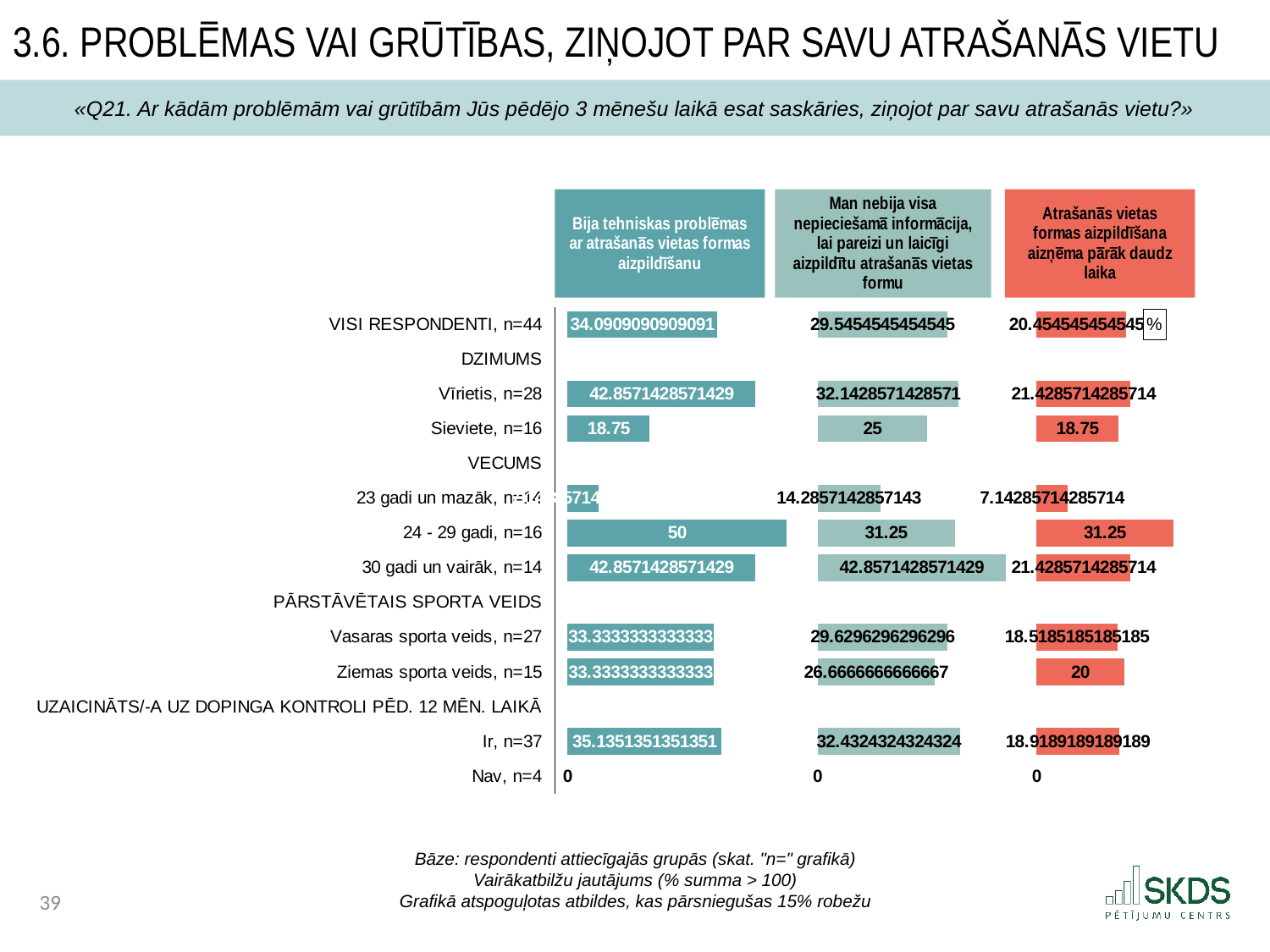
In the middle chart ("Man nebija visa nepieciešamā informācija..."), what is the value for "30 gadi un vairāk, n=14"? 42.8571428571429 In the chart titled "Bija tehniskas problēmas ar atrašanās vietas formas aizpildīšanu", what is the difference between the values for "24 - 29 gadi, n=16" and "Sieviete, n=16"? 31.25 In the chart titled "Bija tehniskas problēmas ar atrašanās vietas formas aizpildīšanu", what is the value for "24 - 29 gadi, n=16"? 50 In the rightmost chart ("Atrašanās vietas formas aizpildīšana aizņēma pārāk daudz laika"), what is the difference between the values for "24 - 29 gadi, n=16" and "Sieviete, n=16"? 12.5 In the middle chart ("Man nebija visa nepieciešamā informācija..."), which group has the highest value? 30 gadi un vairāk, n=14 What kind of chart is used on this slide? Bar chart In the chart titled "Bija tehniskas problēmas ar atrašanās vietas formas aizpildīšanu", which group has the highest value? 24 - 29 gadi, n=16 How many respondent groups have a value plotted in the chart titled "Bija tehniskas problēmas ar atrašanās vietas formas aizpildīšanu"? 10 In the rightmost chart ("Atrašanās vietas formas aizpildīšana aizņēma pārāk daudz laika"), what is the value for "Ziemas sporta veids, n=15"? 20 In the chart titled "Bija tehniskas problēmas ar atrašanās vietas formas aizpildīšanu", what is the value for "Sieviete, n=16"? 18.75 In the middle chart ("Man nebija visa nepieciešamā informācija..."), which is larger: the value for "Vīrietis, n=28" or for "Sieviete, n=16"? Vīrietis, n=28 In the rightmost chart ("Atrašanās vietas formas aizpildīšana aizņēma pārāk daudz laika"), which group has the lowest value? Nav, n=4